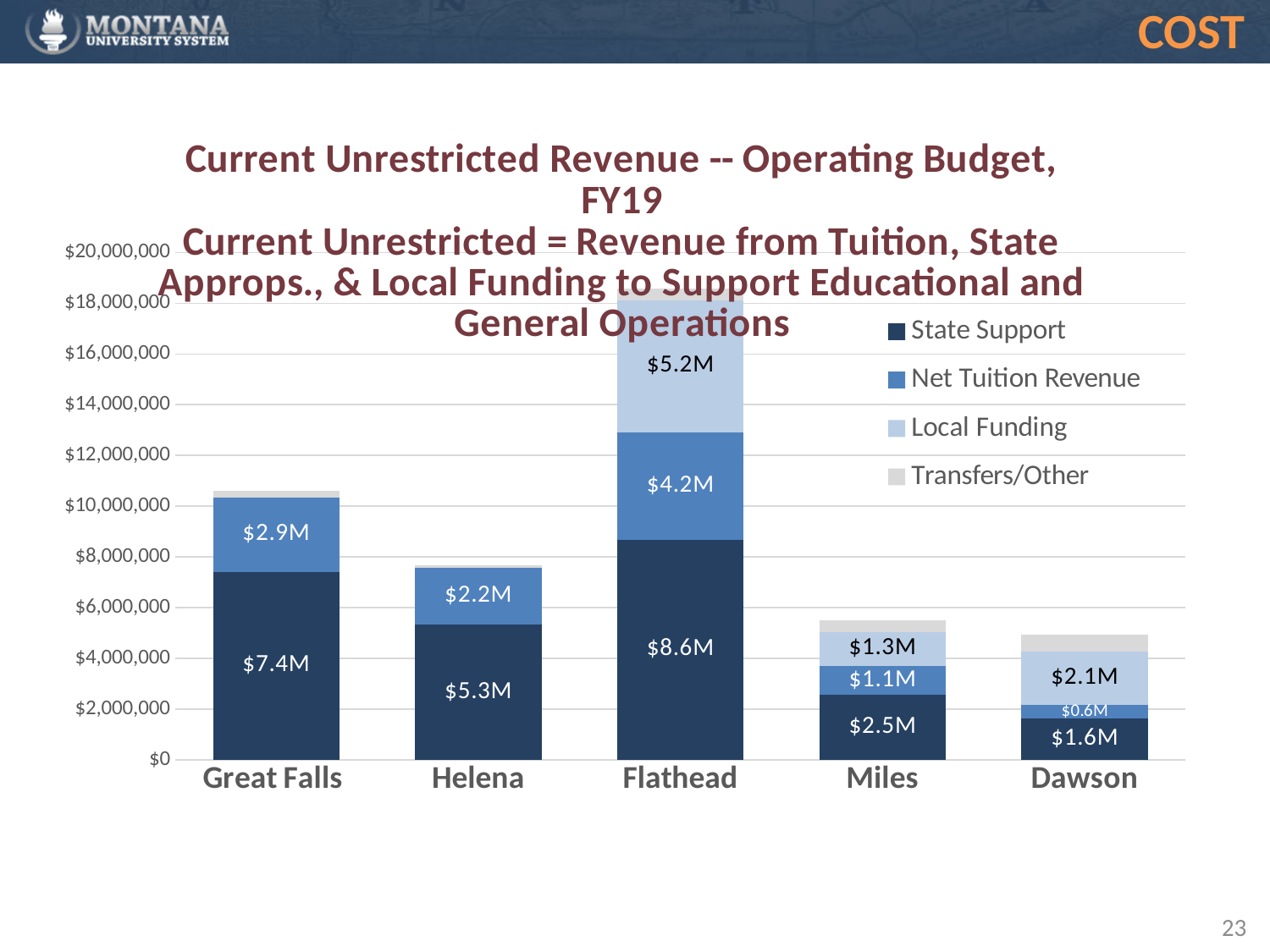
What is the difference between the State Support values for Great Falls and Helena? $2.1M What is the Net Tuition Revenue value for Helena? $2.2M How many campuses are shown along the x axis of the chart? 5 Which is larger, the Net Tuition Revenue for Miles or for Dawson? Miles Is the total height of the Great Falls bar greater or less than $10,000,000? greater What kind of chart is shown on the slide? Stacked bar chart How many series does the chart's legend list? 4 What is the Local Funding value for Dawson? $2.1M Which campus has the highest State Support value? Flathead What is the State Support value for Flathead? $8.6M Which campus has the lowest State Support value? Dawson Which series is listed last in the chart's legend? Transfers/Other